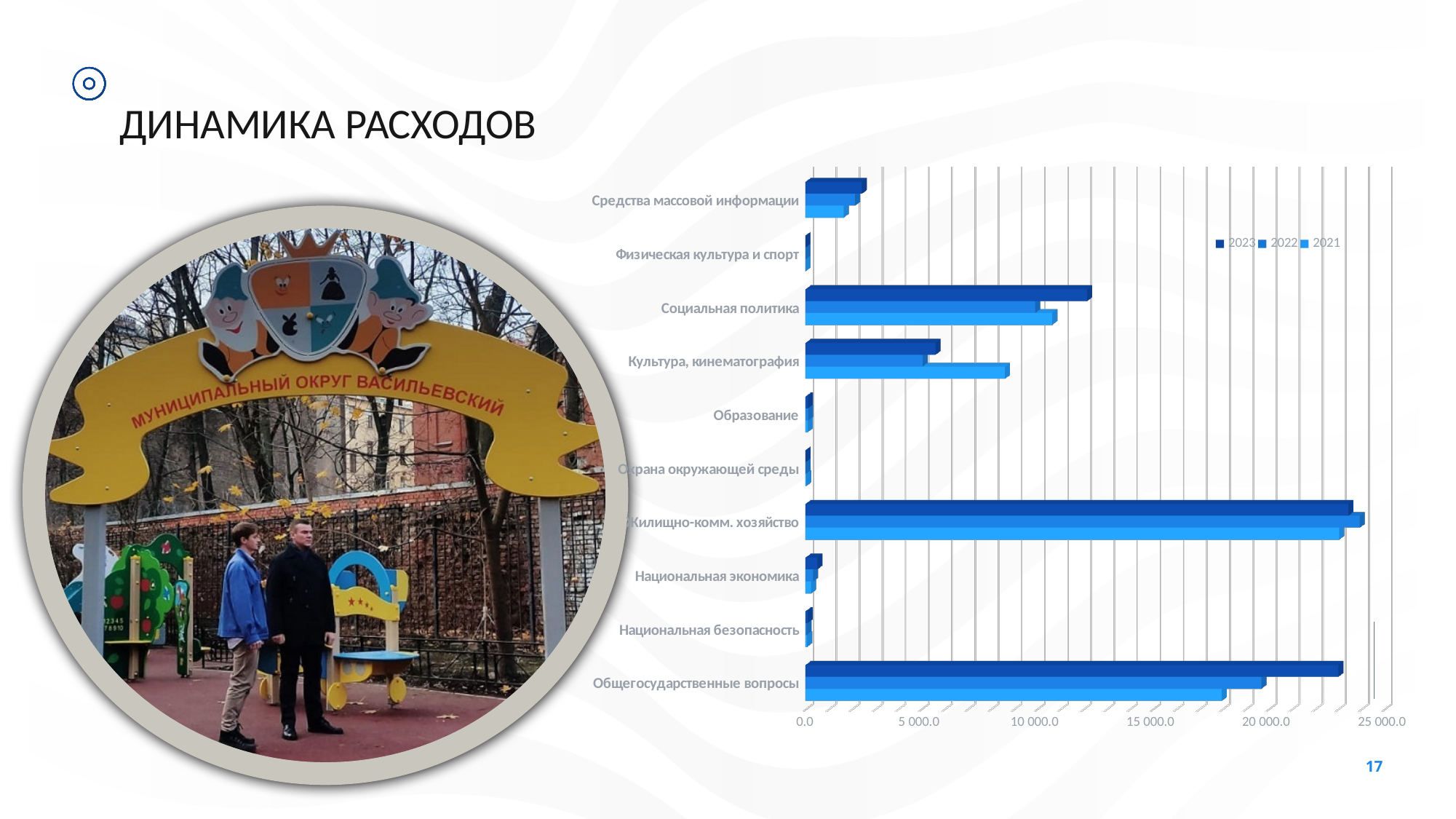
Which years are listed in the chart legend? 2023, 2022, 2021 How many expenditure categories are listed on the chart's vertical axis? 10 Is the 2021 value for Культура, кинематография greater or less than 10 000.0? less Is the 2023 value for Общегосударственные вопросы greater or less than 20 000.0? greater Is the 2023 value for Средства массовой информации greater or less than 5 000.0? less What kind of chart is shown on the slide? bar chart What is the title of the slide containing the chart? ДИНАМИКА РАСХОДОВ For Культура, кинематография, which year has the larger value: 2021 or 2023? 2021 Which category has the longest bar on the chart? Жилищно-комм. хозяйство For Социальная политика, which year has the larger value: 2023 or 2022? 2023 How many series does the chart legend list? 3